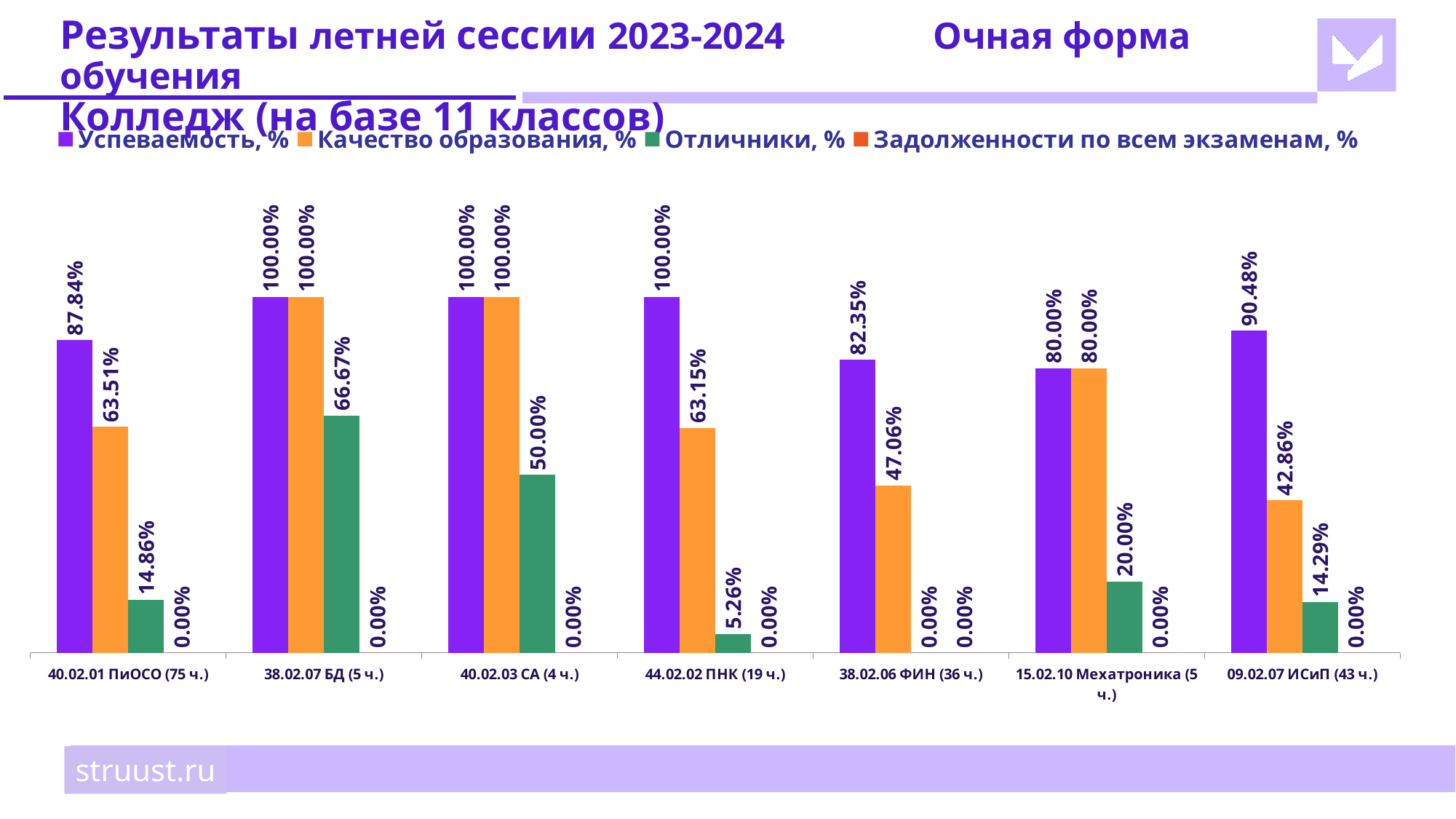
What is the value of Качество образования, % for 38.02.06 ФИН (36 ч.)? 47.06% Which series is shown in orange in the legend? Качество образования, % Which category has the highest value of Отличники, %? 38.02.07 БД (5 ч.) How many categories are shown on the x axis? 7 What is the value of Задолженности по всем экзаменам, % for 09.02.07 ИСиП (43 ч.)? 0.00% Which is larger: Отличники, % for 40.02.03 СА (4 ч.) or Отличники, % for 15.02.10 Мехатроника (5 ч.)? 40.02.03 СА (4 ч.) What kind of chart is shown on the slide? Bar chart Which category has the lowest value of Успеваемость, %? 15.02.10 Мехатроника (5 ч.) How many series does the legend list? 4 What is the value of Успеваемость, % for 40.02.01 ПиОСО (75 ч.)? 87.84% What is the difference between Успеваемость, % and Качество образования, % for 09.02.07 ИСиП (43 ч.)? 47.62% What is the value of Отличники, % for 38.02.07 БД (5 ч.)? 66.67%